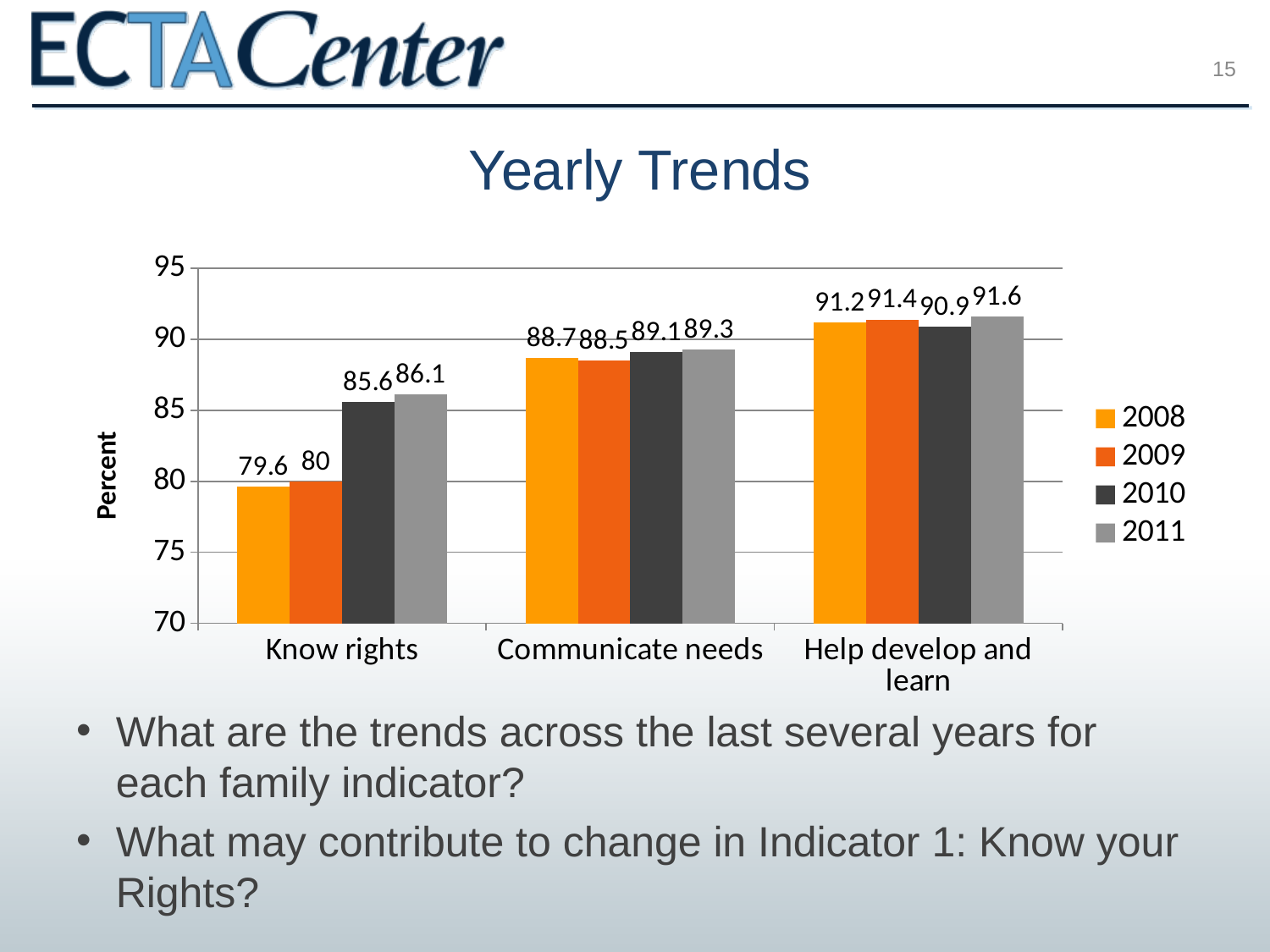
Is the 2008 value for Know rights greater or less than 80? less What is the value for Communicate needs in 2011? 89.3 Which category has the lowest value in 2009? Know rights What is the title of the chart? Yearly Trends How many series does the legend list? 4 Which category has the highest value in 2011? Help develop and learn What is the difference between the 2011 and 2008 values for Know rights? 6.5 Which is larger, the 2010 value for Know rights or the 2010 value for Communicate needs? Communicate needs What is the value for Know rights in 2008? 79.6 How many categories are shown on the x axis? 3 What kind of chart is shown on the slide? bar chart What is the value for Help develop and learn in 2010? 90.9